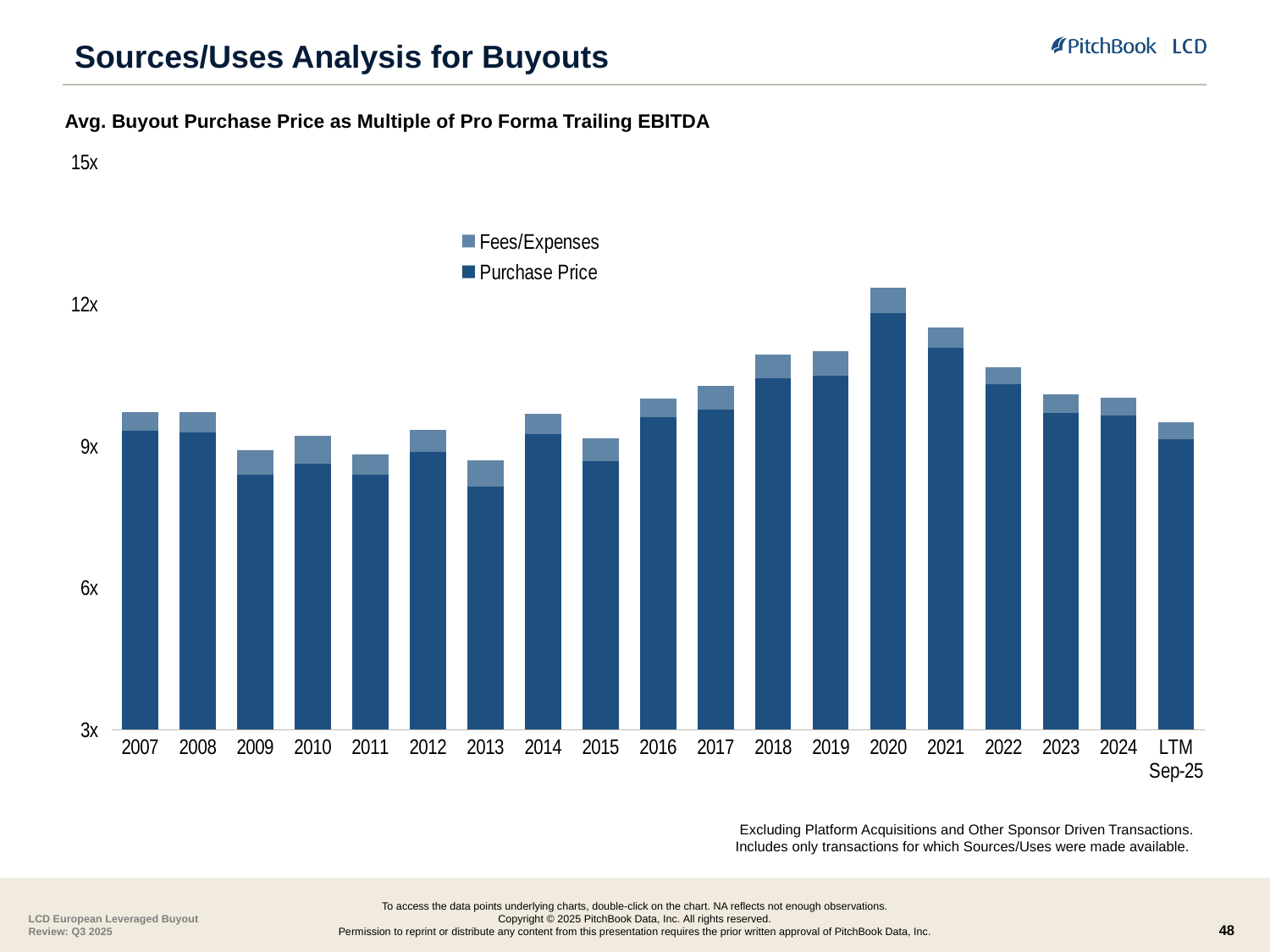
Is the total value for 2020 greater or less than 12x? greater Which is larger, the total for 2007 or the total for 2013? 2007 Do the total values generally rise or fall from 2013 to 2020? rise Is the total value for 2013 greater or less than 9x? less Which year has the lowest total purchase price multiple? 2013 What are the two series named in the legend? Fees/Expenses and Purchase Price Is the total value for 2021 greater or less than 12x? less How many series does the legend list? 2 What kind of chart is shown on the slide? Stacked bar chart How many periods (bars) are shown along the x axis? 19 Which is larger, the total for 2020 or the total for 2021? 2020 Which year has the highest total purchase price multiple? 2020